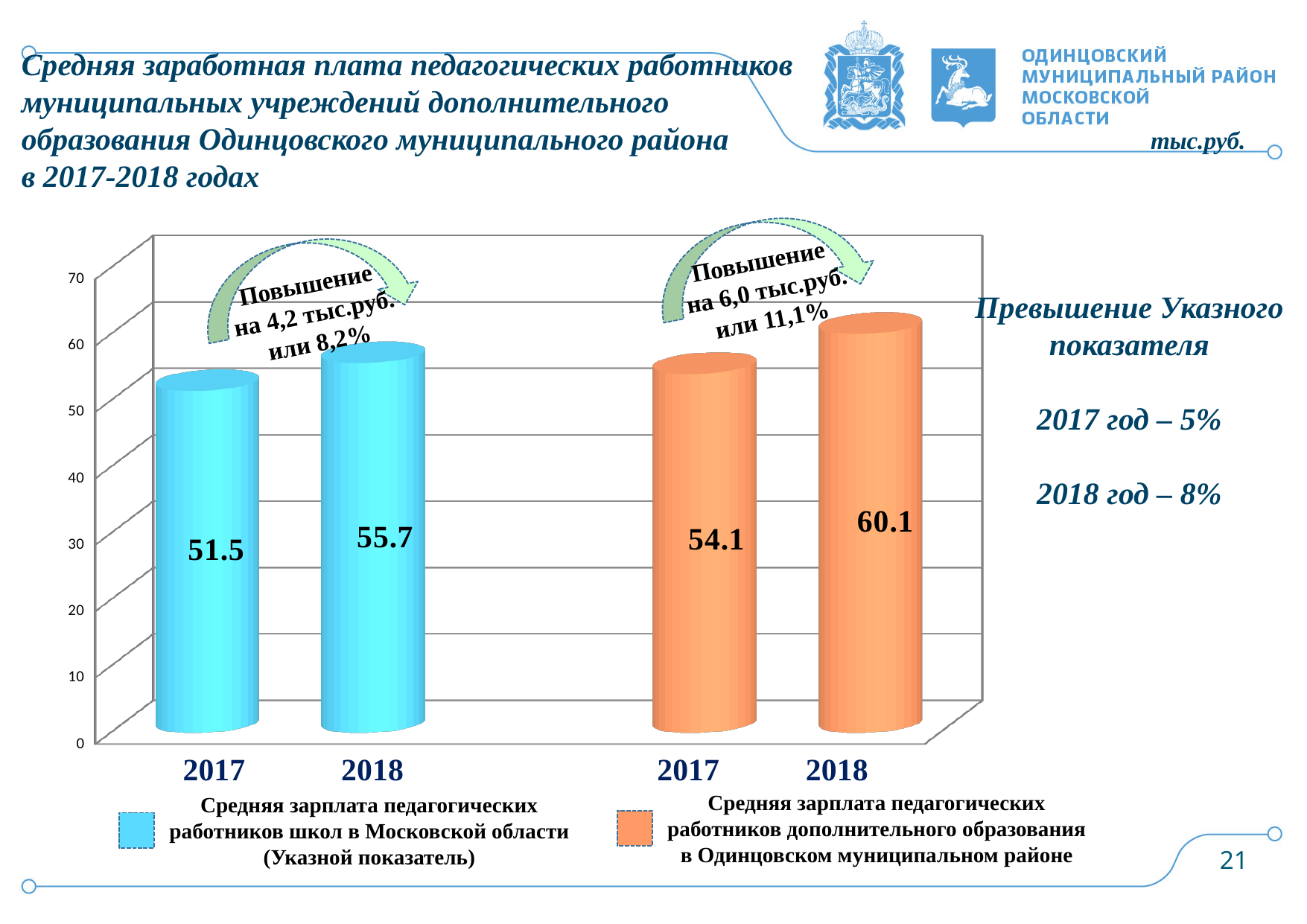
Which bar has the lowest value on the chart? 2017, Средняя зарплата педагогических работников школ в Московской области (Указной показатель) (51.5) What is the value for 2017 for the series 'Средняя зарплата педагогических работников школ в Московской области (Указной показатель)'? 51.5 What kind of chart is shown on the slide? bar chart What is the value for 2018 for the series 'Средняя зарплата педагогических работников дополнительного образования в Одинцовском муниципальном районе'? 60.1 What is the value for 2018 for the series 'Средняя зарплата педагогических работников школ в Московской области (Указной показатель)'? 55.7 Do the values for the orange series rise or fall from 2017 to 2018? rise What is the value for 2017 for the series 'Средняя зарплата педагогических работников дополнительного образования в Одинцовском муниципальном районе'? 54.1 What is the difference between the 2018 and 2017 values for the blue series (Указной показатель)? 4.2 How many series does the legend list? 2 Which bar has the highest value on the chart? 2018, Средняя зарплата педагогических работников дополнительного образования в Одинцовском муниципальном районе (60.1) What is the difference between the 2018 and 2017 values for the orange series (дополнительного образования в Одинцовском муниципальном районе)? 6.0 Which is larger in 2017: the blue series (Указной показатель) or the orange series (Одинцовский муниципальный район)? the orange series (Одинцовский муниципальный район), 54.1